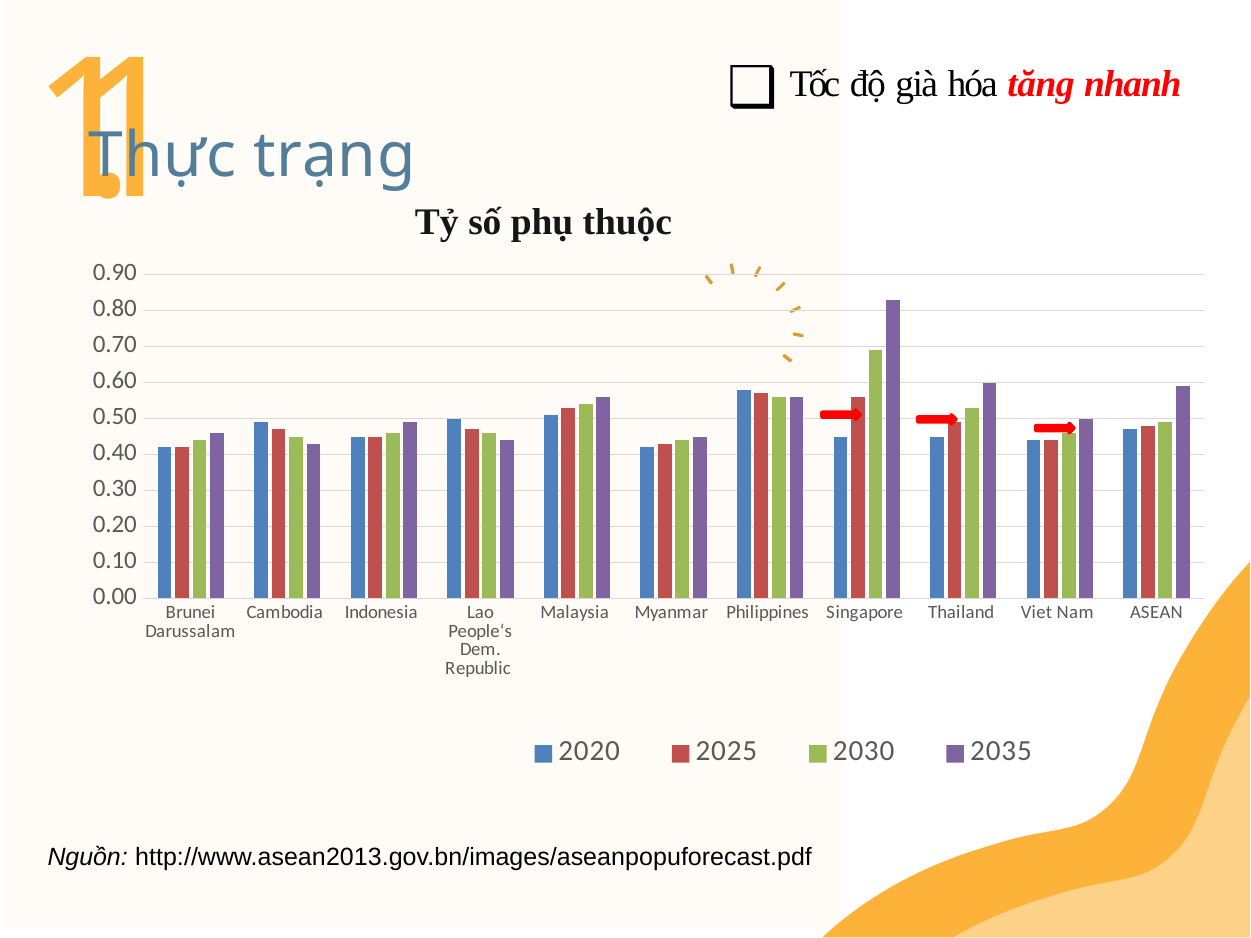
What kind of chart is shown on the slide? Bar chart What is the title of the chart? Tỷ số phụ thuộc Is the 2035 value for Singapore greater or less than 0.80? greater Which category has the highest value for the 2020 series? Philippines Which years are listed in the legend? 2020, 2025, 2030, 2035 Which category has the highest value for the 2035 series? Singapore Which is larger, the 2020 value for Philippines or the 2020 value for Brunei Darussalam? Philippines Is the 2030 value for Singapore greater or less than 0.60? greater Do the values for Singapore rise or fall from 2020 to 2035? rise How many series does the legend list? 4 Is the 2035 value for Thailand greater or less than 0.50? greater How many categories are shown on the x axis? 11